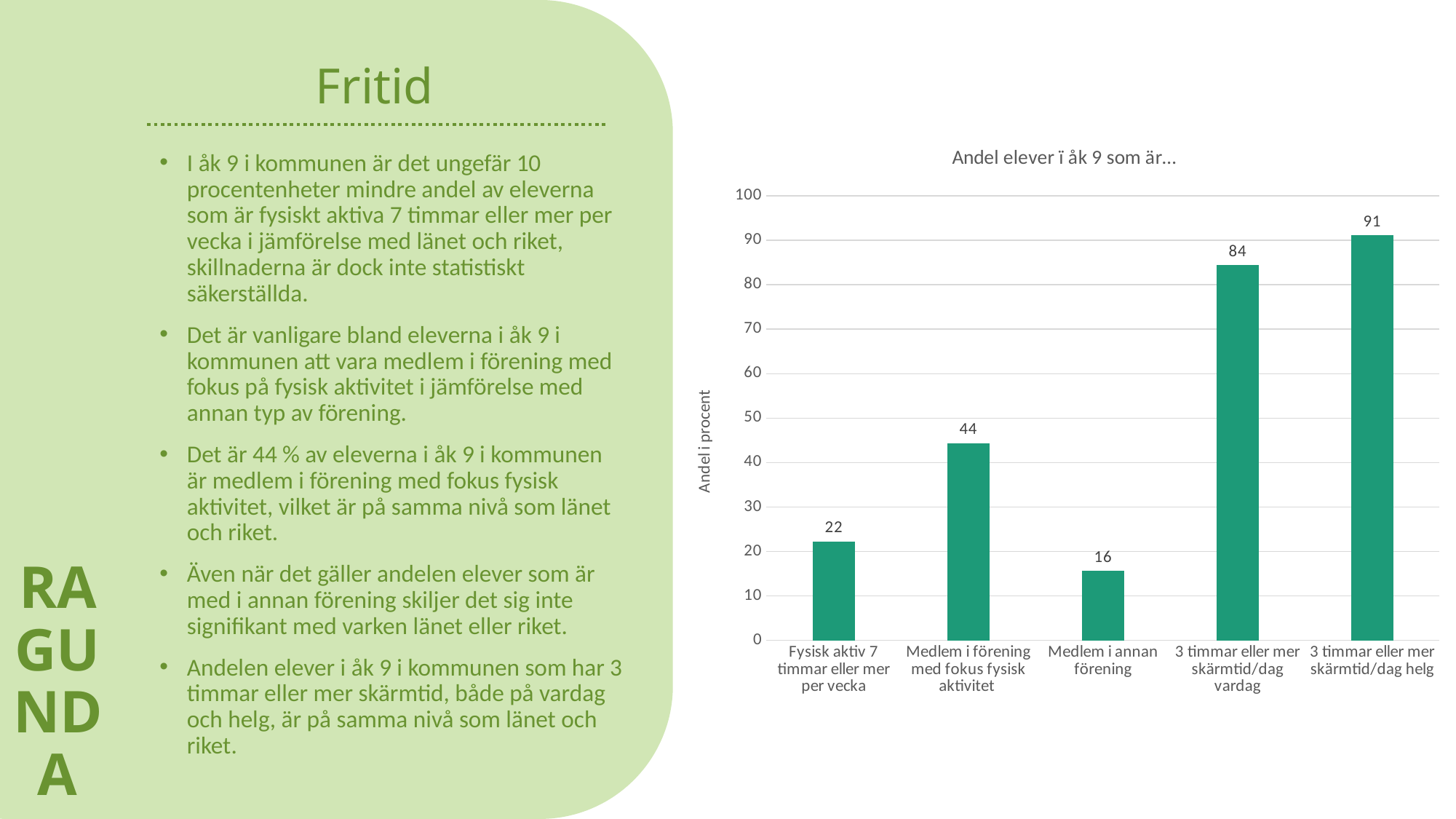
How many categories are shown in the chart? 5 What is the difference between the values for "Medlem i förening med fokus fysisk aktivitet" and "Medlem i annan förening"? 28 Is the value for "3 timmar eller mer skärmtid/dag vardag" greater or less than 80? greater What kind of chart is shown on the slide? Bar chart What is the title of the chart? Andel elever ï åk 9 som är… Which is larger: the value for "Fysisk aktiv 7 timmar eller mer per vecka" or "Medlem i annan förening"? Fysisk aktiv 7 timmar eller mer per vecka What is the value for "Medlem i annan förening"? 16 What is the value for "3 timmar eller mer skärmtid/dag helg"? 91 Which category has the highest value? 3 timmar eller mer skärmtid/dag helg What is the difference between the values for "3 timmar eller mer skärmtid/dag helg" and "3 timmar eller mer skärmtid/dag vardag"? 7 Which category has the lowest value? Medlem i annan förening What is the value for "Medlem i förening med fokus fysisk aktivitet"? 44